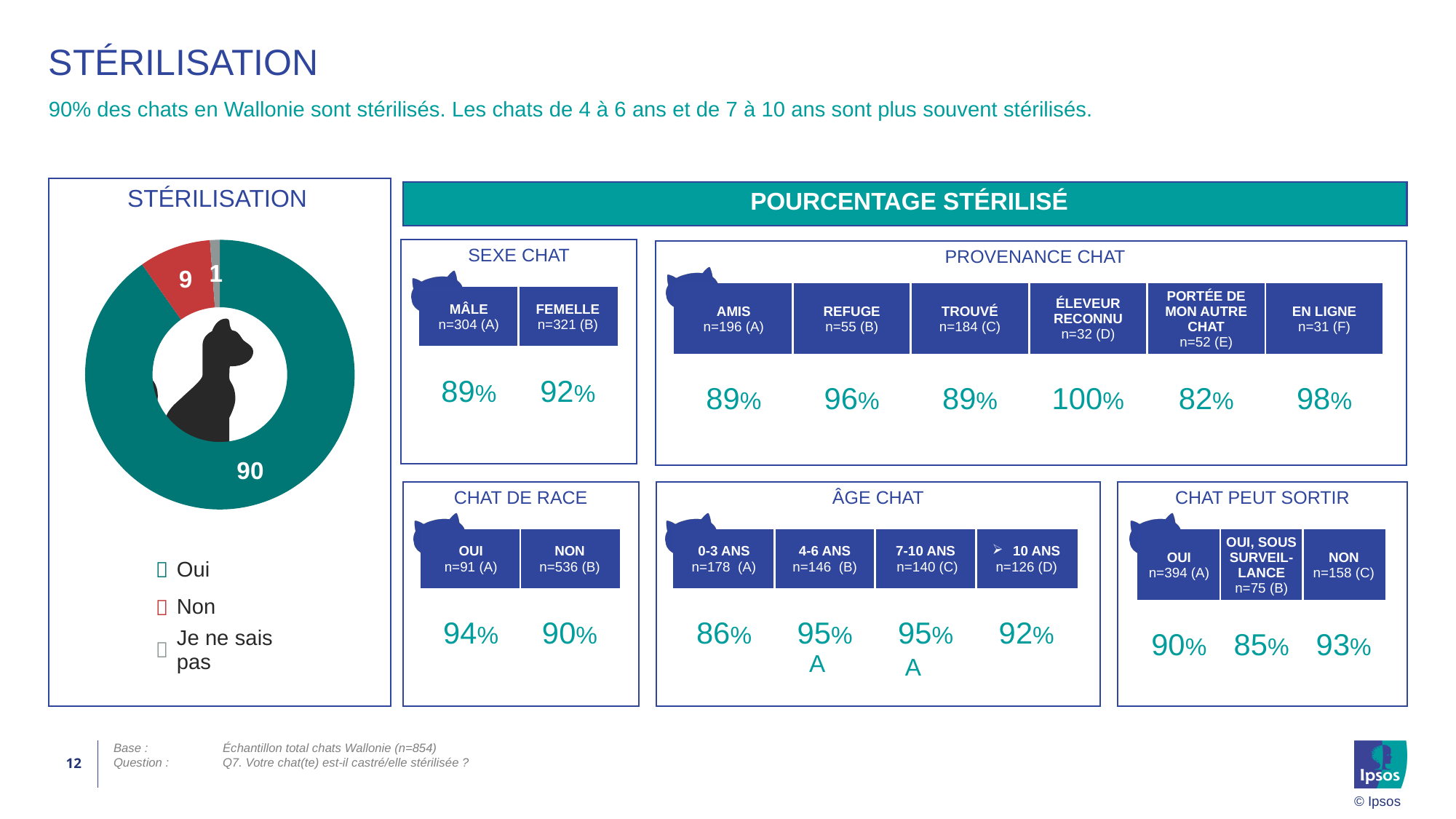
How many categories does the STÉRILISATION donut chart show? 3 In the STÉRILISATION donut chart, what value is shown for Je ne sais pas? 1 In the STÉRILISATION donut chart, what value is shown for Non? 9 In the STÉRILISATION donut chart, what value is shown for Oui? 90 In the STÉRILISATION donut chart, which category has the largest slice? Oui What kind of chart is shown in the STÉRILISATION panel on the left? pie chart (donut) In the STÉRILISATION donut chart, which is larger: Non or Je ne sais pas? Non In the STÉRILISATION donut chart, what share of the whole does the Oui slice represent? 90% In the STÉRILISATION donut chart, which category has the smallest slice? Je ne sais pas What colour is the Oui slice in the STÉRILISATION donut chart? teal green What are the legend entries of the STÉRILISATION donut chart? Oui, Non, Je ne sais pas In the STÉRILISATION donut chart, what is the difference between the Oui and Non values? 81